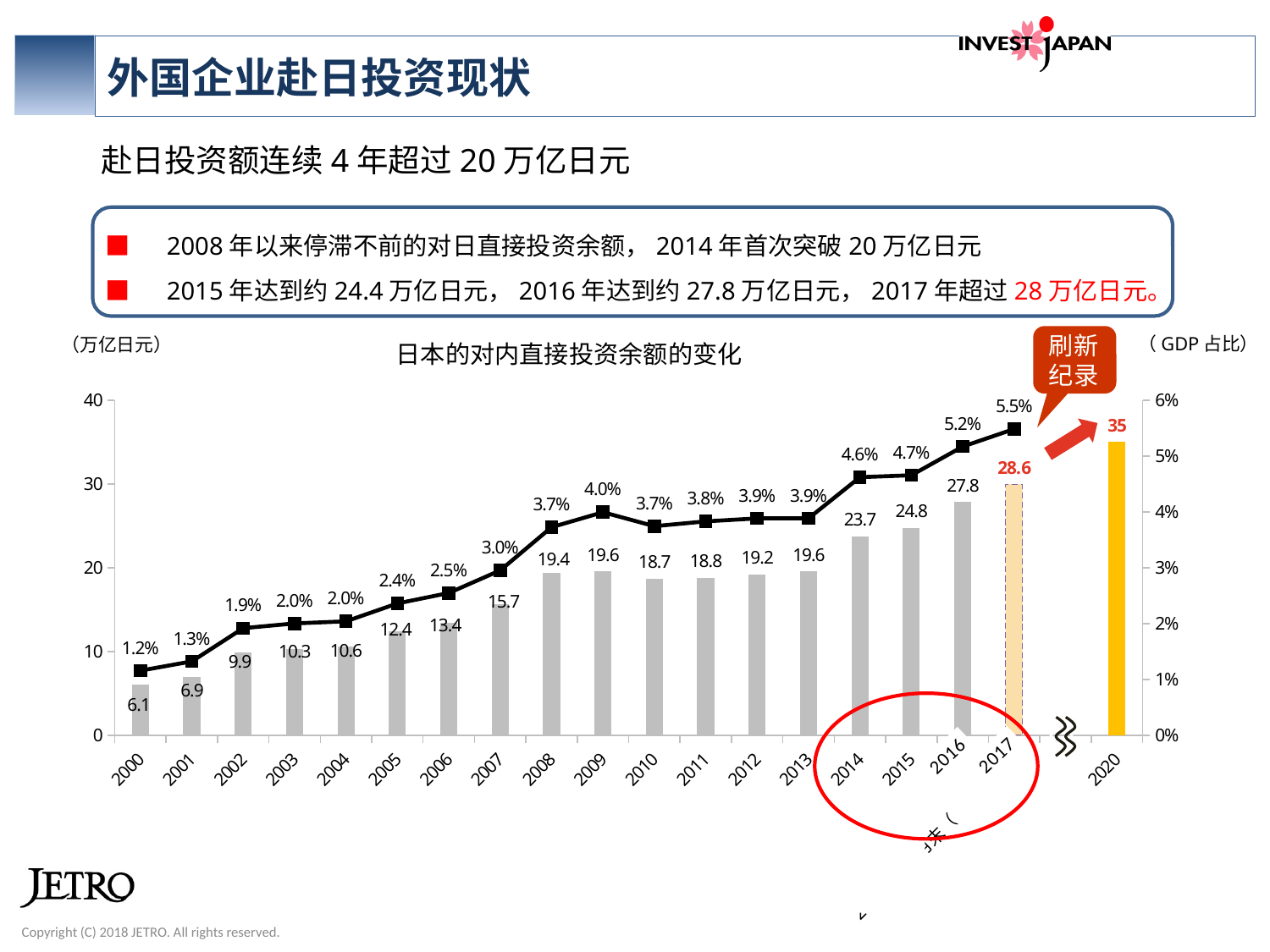
What GDP share percentage is shown on the line for 2009? 4.0% Which year has the highest bar value? 2020 What is the title of the chart? 日本的对内直接投资余额的变化 Which year has the lowest bar value? 2000 What is the difference between the bar values for 2016 and 2015? 3.0 How many years are labelled on the x axis? 19 What is the bar value for 2017? 28.6 What is the bar value for 2008? 19.4 Does the GDP share line generally rise or fall from 2000 to 2017? rise Is the bar value for 2014 greater or less than 20? greater What GDP share percentage is shown on the line for 2017? 5.5% Which is larger, the bar value for 2010 or for 2009? 2009